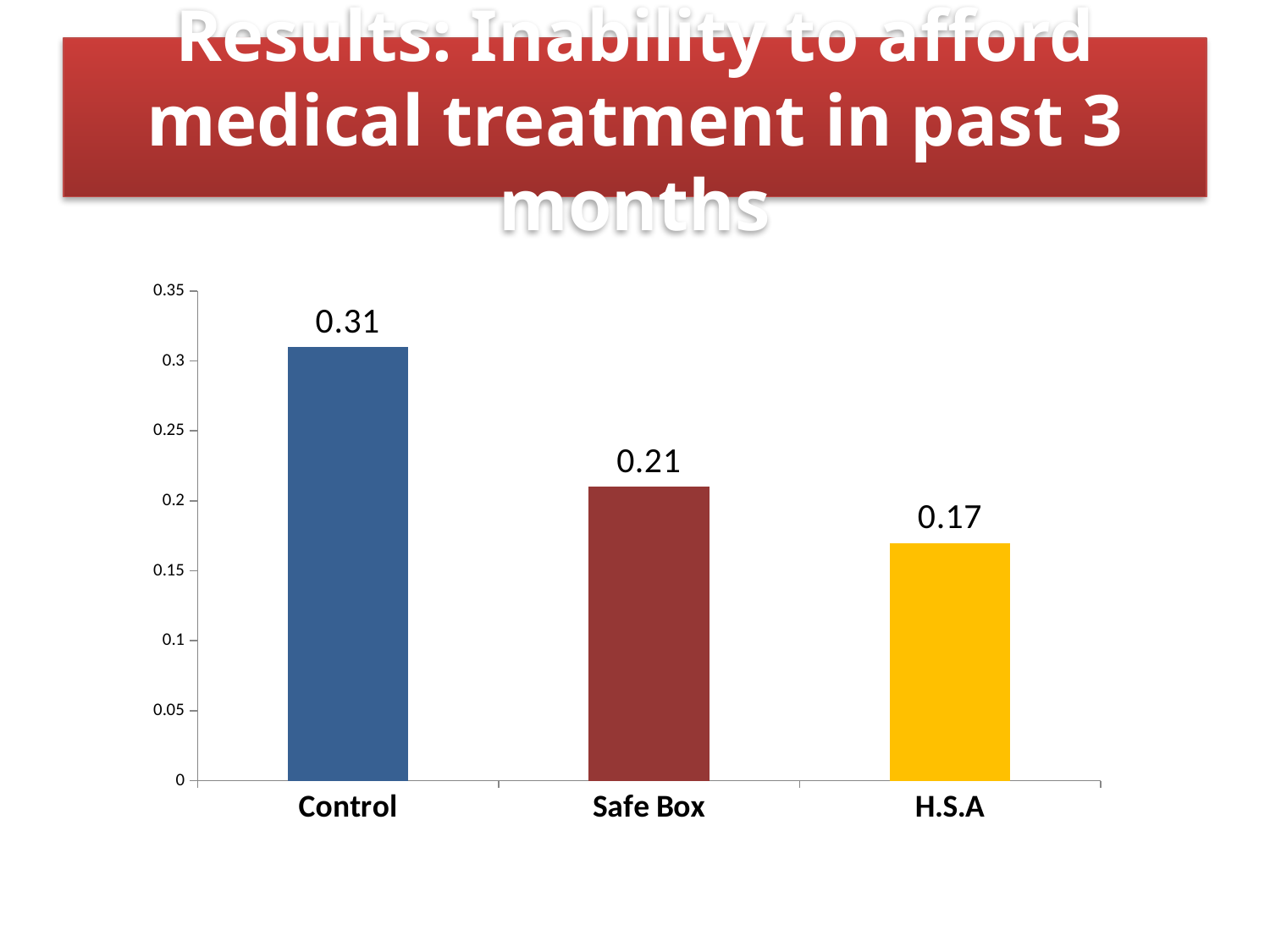
Which category has the highest value? Control Is the value for Control greater or less than 0.25? greater What is the value for Safe Box? 0.21 What kind of chart is shown on the slide? bar chart What is the value for H.S.A? 0.17 Which is larger, the value for Safe Box or the value for H.S.A? Safe Box What is the difference between the values for Safe Box and H.S.A? 0.04 What is the difference between the values for Control and Safe Box? 0.1 Do the values rise or fall from left to right along the x axis? fall Which category has the lowest value? H.S.A What is the value for Control? 0.31 How many categories are shown on the x axis? 3